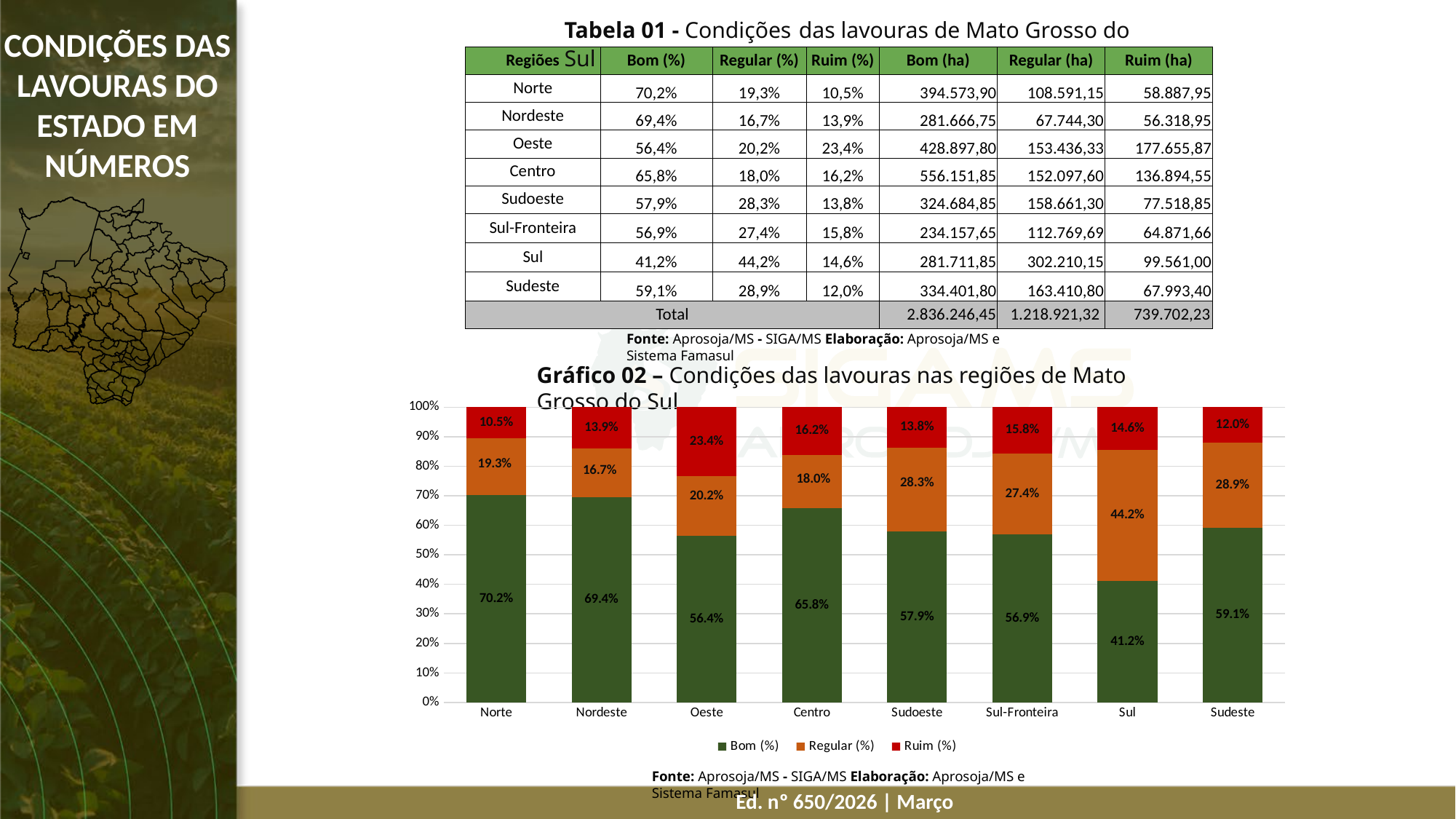
Which region has the lowest Bom (%) value in Gráfico 02? Sul What is the Regular (%) value for Sul in Gráfico 02? 44.2% In Gráfico 02, which is larger: the Regular (%) value for Sudeste or for Sudoeste? Sudeste Which region has the highest Ruim (%) value in Gráfico 02? Oeste How many series does the legend of Gráfico 02 list? 3 Which region has the highest Bom (%) value in Gráfico 02? Norte What is the Ruim (%) value for Oeste in Gráfico 02? 23.4% How many regions are shown on the x axis of Gráfico 02? 8 What is the Bom (%) value for Norte in Gráfico 02? 70.2% What kind of chart is Gráfico 02? Stacked bar chart Which region has the lowest Ruim (%) value in Gráfico 02? Norte What is the difference between the Bom (%) values for Norte and Sul in Gráfico 02? 29.0 percentage points